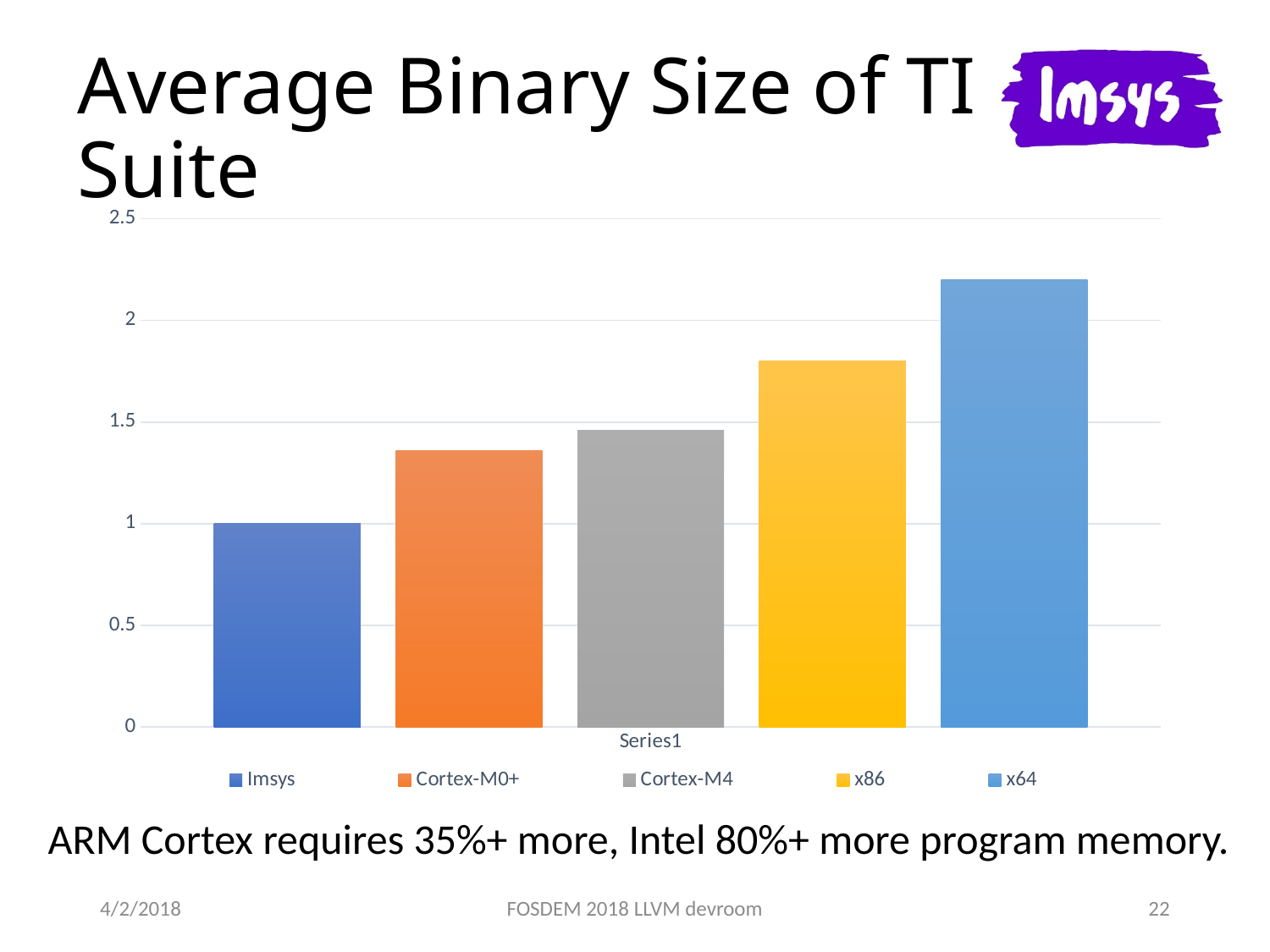
Is the value for x86 greater or less than 2? less Which is larger, the bar for x86 or the bar for Cortex-M4? x86 Is the value for x64 greater or less than 2? greater Which legend entry is shown in orange? Cortex-M0+ What is the value of the Imsys bar? 1 Is the value for Cortex-M0+ greater or less than 1.5? less What type of chart is shown on the slide? bar chart Which series has the shortest bar in the chart? Imsys Which series has the tallest bar in the chart? x64 How many series does the chart legend list? 5 What is the title of the chart on the slide? Average Binary Size of TI Suite